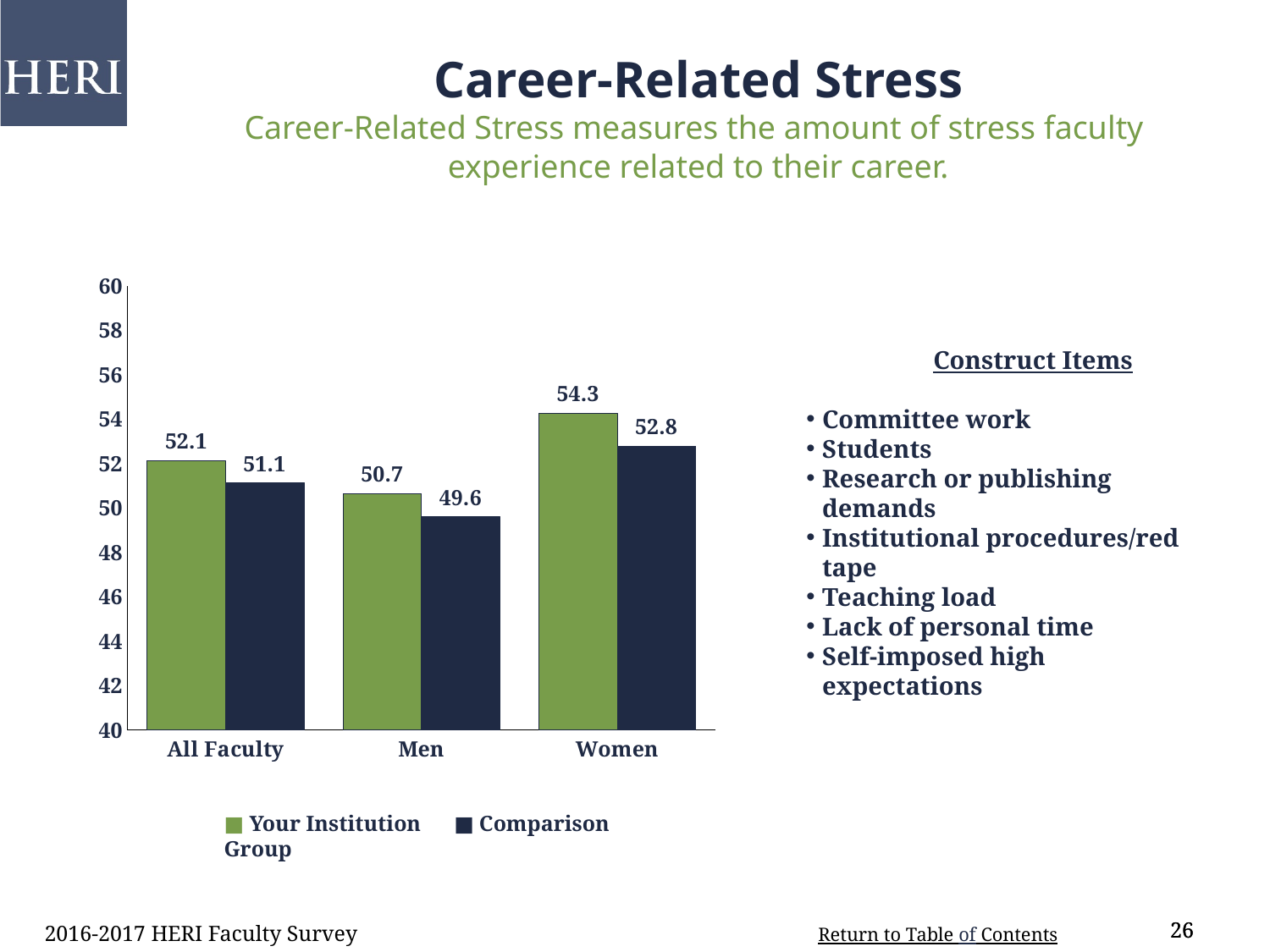
Which is larger for All Faculty, the Your Institution value or the Comparison Group value? Your Institution What is the difference between the Your Institution and Comparison Group values for Women? 1.5 How many categories are shown on the x axis? 3 Is the Comparison Group value for Men greater or less than 50? less How many series does the legend list? 2 What kind of chart is shown on the slide? bar chart Which category has the highest Your Institution value? Women What is the Your Institution value for All Faculty? 52.1 What is the Your Institution value for Women? 54.3 What is the Comparison Group value for Men? 49.6 What is the difference between the Your Institution values for Women and Men? 3.6 Which category has the lowest Comparison Group value? Men